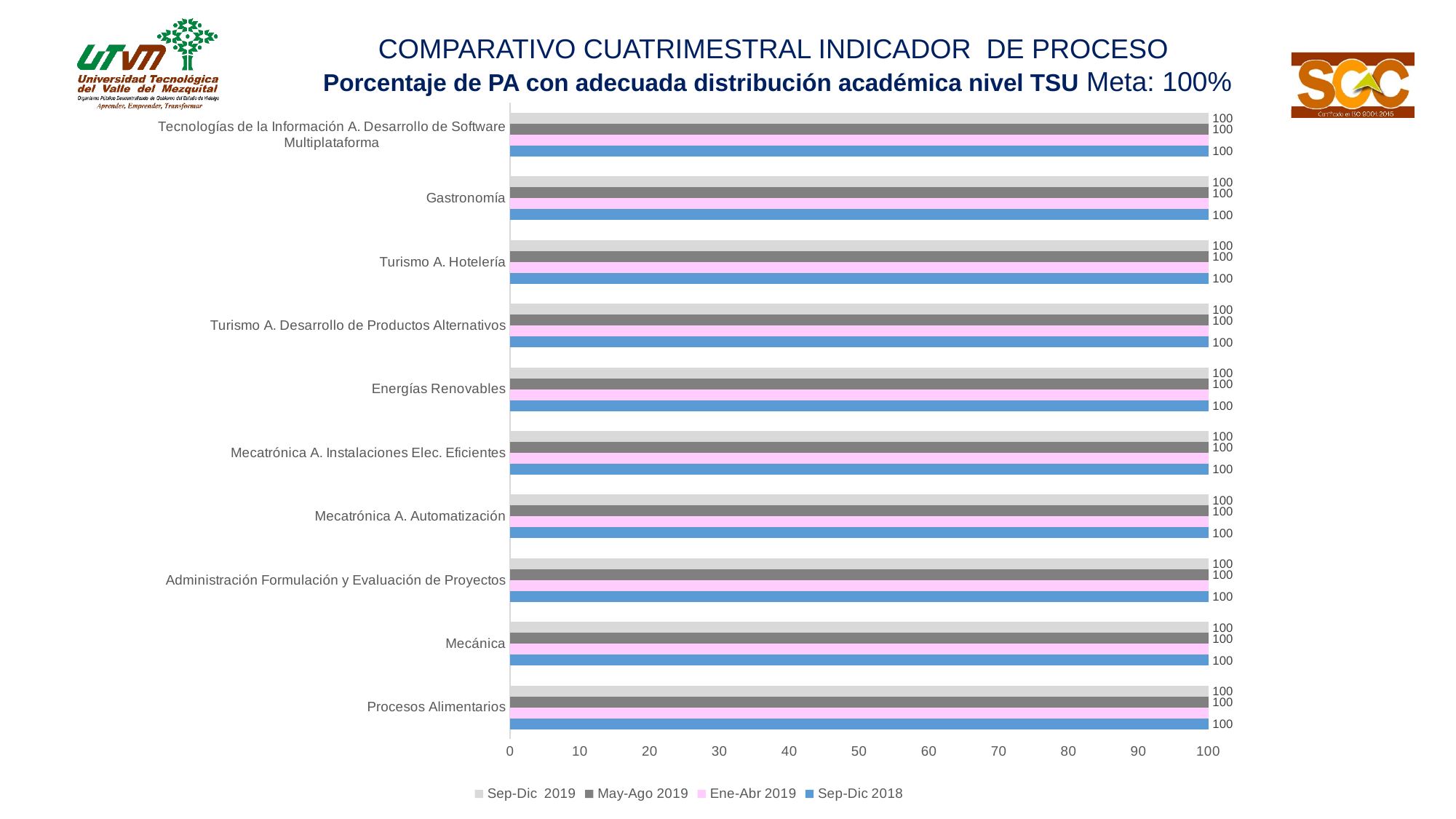
What is the value for Mecánica in the May-Ago 2019 series? 100 What is the value for Procesos Alimentarios in the Sep-Dic 2019 series? 100 What is the value for Administración Formulación y Evaluación de Proyectos in the Ene-Abr 2019 series? 100 What is the target (Meta) stated in the chart title? 100% What is the difference between the Sep-Dic 2019 and Sep-Dic 2018 values for Turismo A. Hotelería? 0 How many categories are shown on the chart? 10 Which series is shown in blue in the legend? Sep-Dic 2018 What kind of chart is shown on the slide? bar chart What is the value for Gastronomía in the Sep-Dic 2018 series? 100 Is the value for Mecatrónica A. Automatización in the May-Ago 2019 series greater or less than 90? greater How many series does the legend list? 4 What is the value for Energías Renovables in the Ene-Abr 2019 series? 100